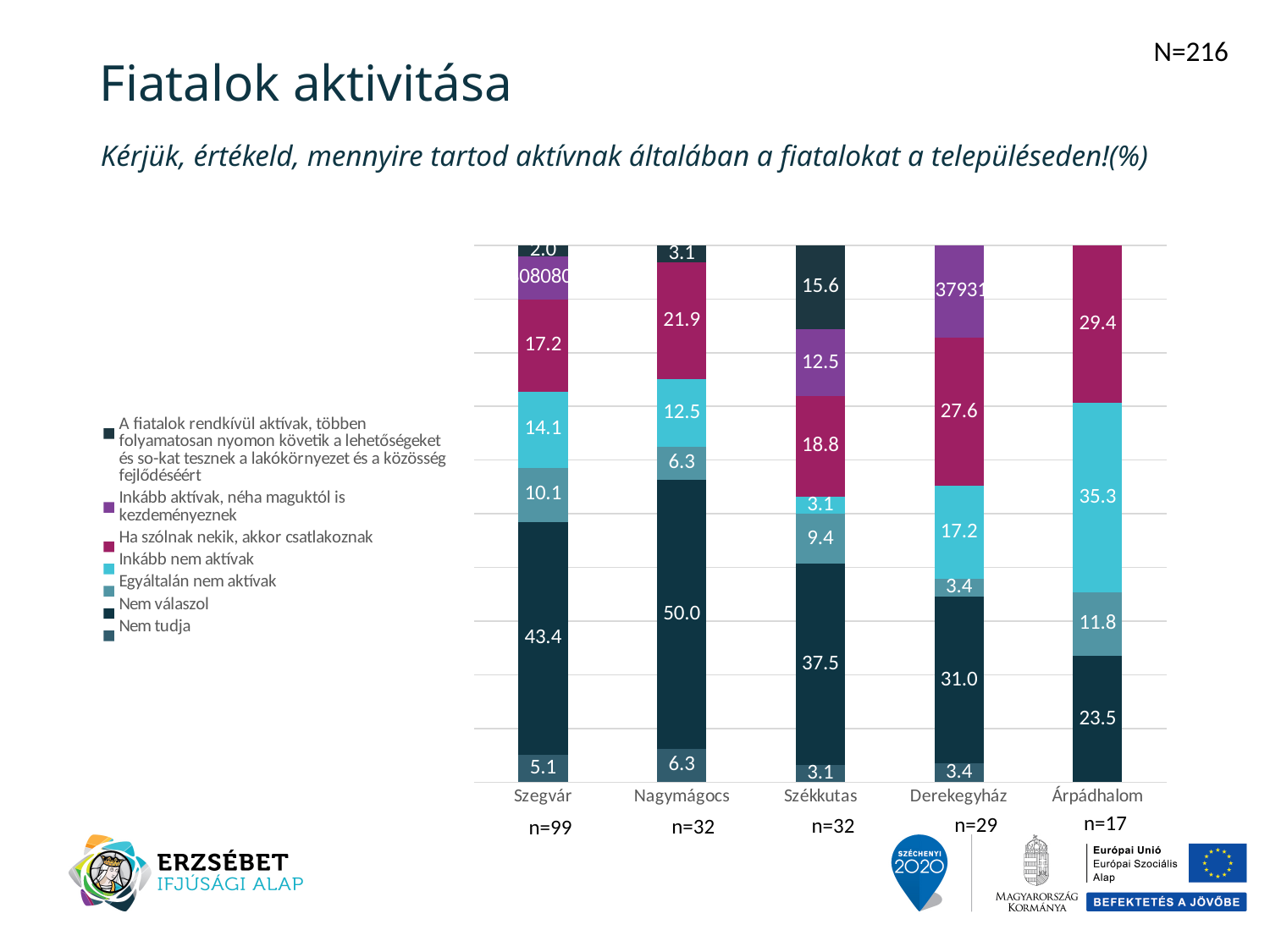
What is the value of the largest segment in the Nagymágocs bar? 50.0 How many series does the chart legend list? 7 What is the difference between the 'Ha szólnak nekik, akkor csatlakoznak' values for Derekegyház and Szegvár? 10.4 What kind of chart is shown on the slide? Stacked bar chart Which settlement has the lowest value for 'Inkább nem aktívak'? Székkutas What sample size (n) is shown under the Szegvár bar? n=99 Which settlement has the larger 'Egyáltalán nem aktívak' value, Szegvár or Székkutas? Szegvár Which settlement has the highest value for 'Inkább nem aktívak'? Árpádhalom What is the value of the 'Inkább nem aktívak' segment for Árpádhalom? 35.3 What is the value of the bottom segment of the Szegvár bar? 5.1 What is the value of the 'Ha szólnak nekik, akkor csatlakoznak' segment for Árpádhalom? 29.4 How many settlements (categories) are shown on the x axis of the chart? 5